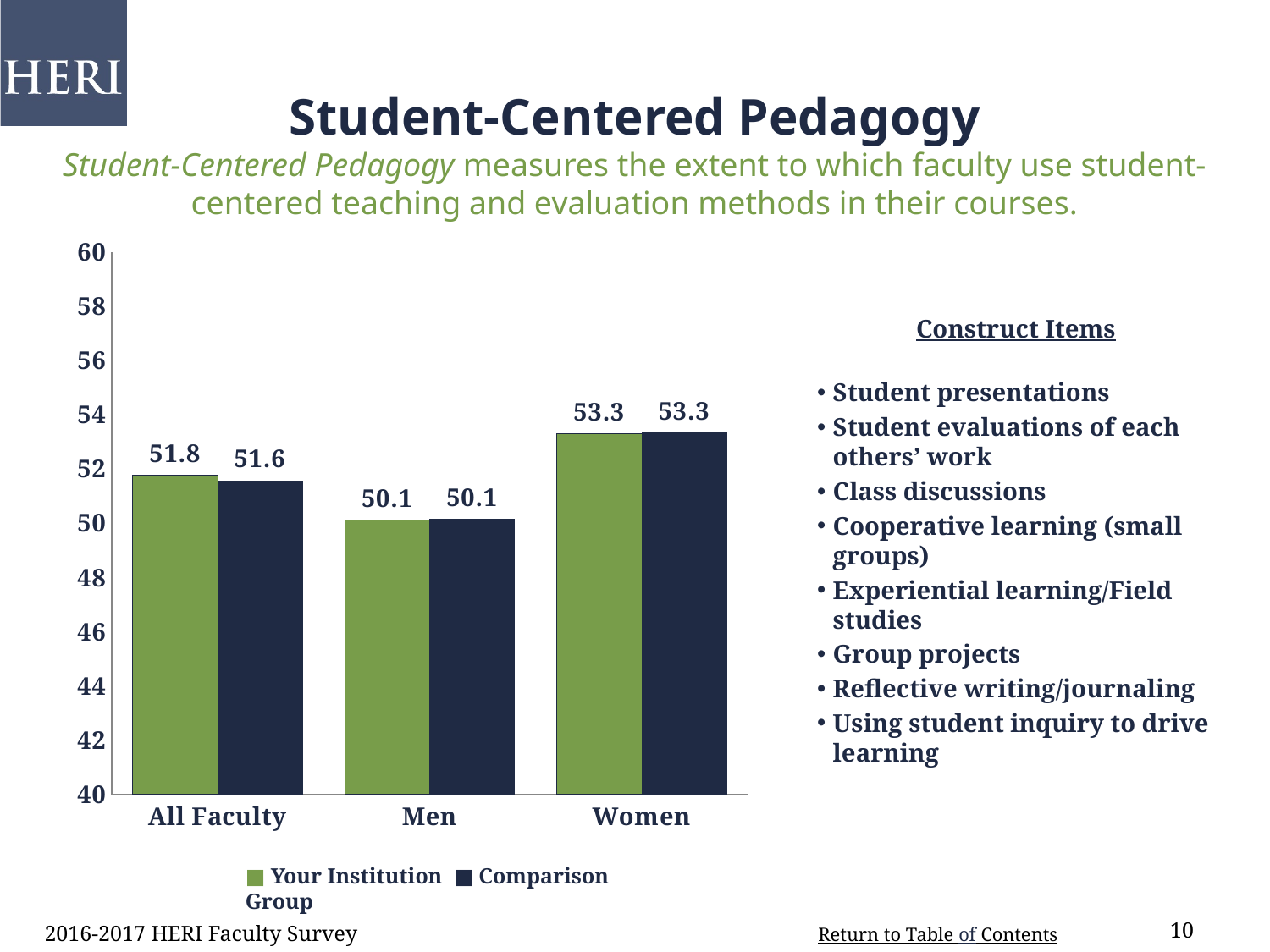
How many categories are shown on the x axis? 3 What kind of chart is shown on the slide? Bar chart What is the Your Institution value for All Faculty? 51.8 What is the difference between the Your Institution values for Women and Men? 3.2 Which category has the highest Your Institution value? Women What is the Comparison Group value for All Faculty? 51.6 What is the Your Institution value for Women? 53.3 Which category has the lowest Comparison Group value? Men What is the Comparison Group value for Men? 50.1 How many series does the legend list? 2 What is the difference between the Your Institution and Comparison Group values for All Faculty? 0.2 Which is larger for All Faculty: the Your Institution value or the Comparison Group value? Your Institution